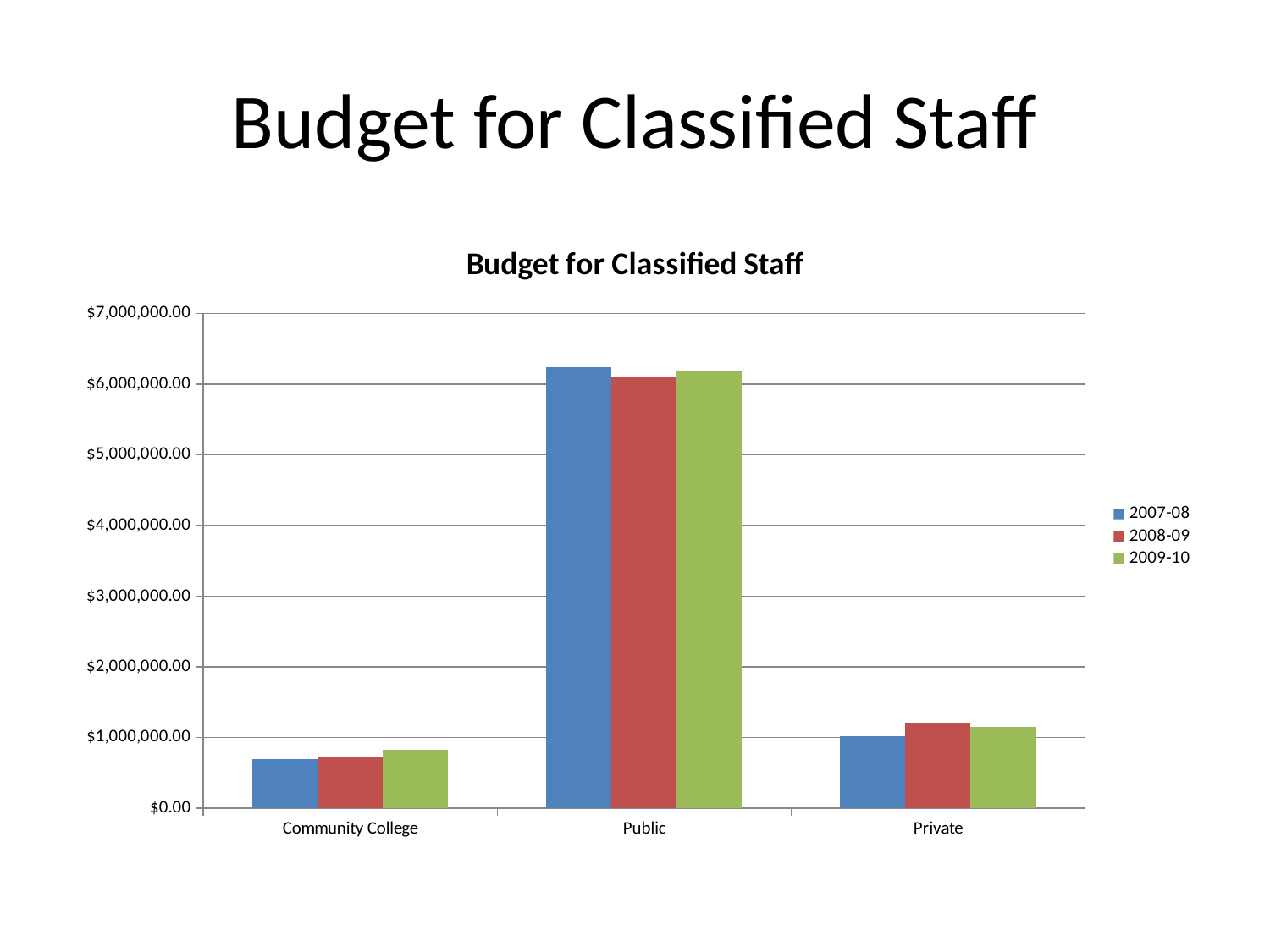
Which category has the lowest budget for classified staff in 2009-10? Community College What is the title of the chart? Budget for Classified Staff Is the 2008-09 value for Private greater or less than $1,000,000.00? greater Is the 2007-08 value for Community College greater or less than $1,000,000.00? less How many categories are shown on the x axis? 3 For Community College, which is larger: the 2007-08 value or the 2009-10 value? 2009-10 Is the 2007-08 value for Public greater or less than $6,000,000.00? greater Which category has the highest budget for classified staff in 2007-08? Public For Private, which is larger: the 2007-08 value or the 2008-09 value? 2008-09 What type of chart is shown on the slide? bar chart How many series does the legend list? 3